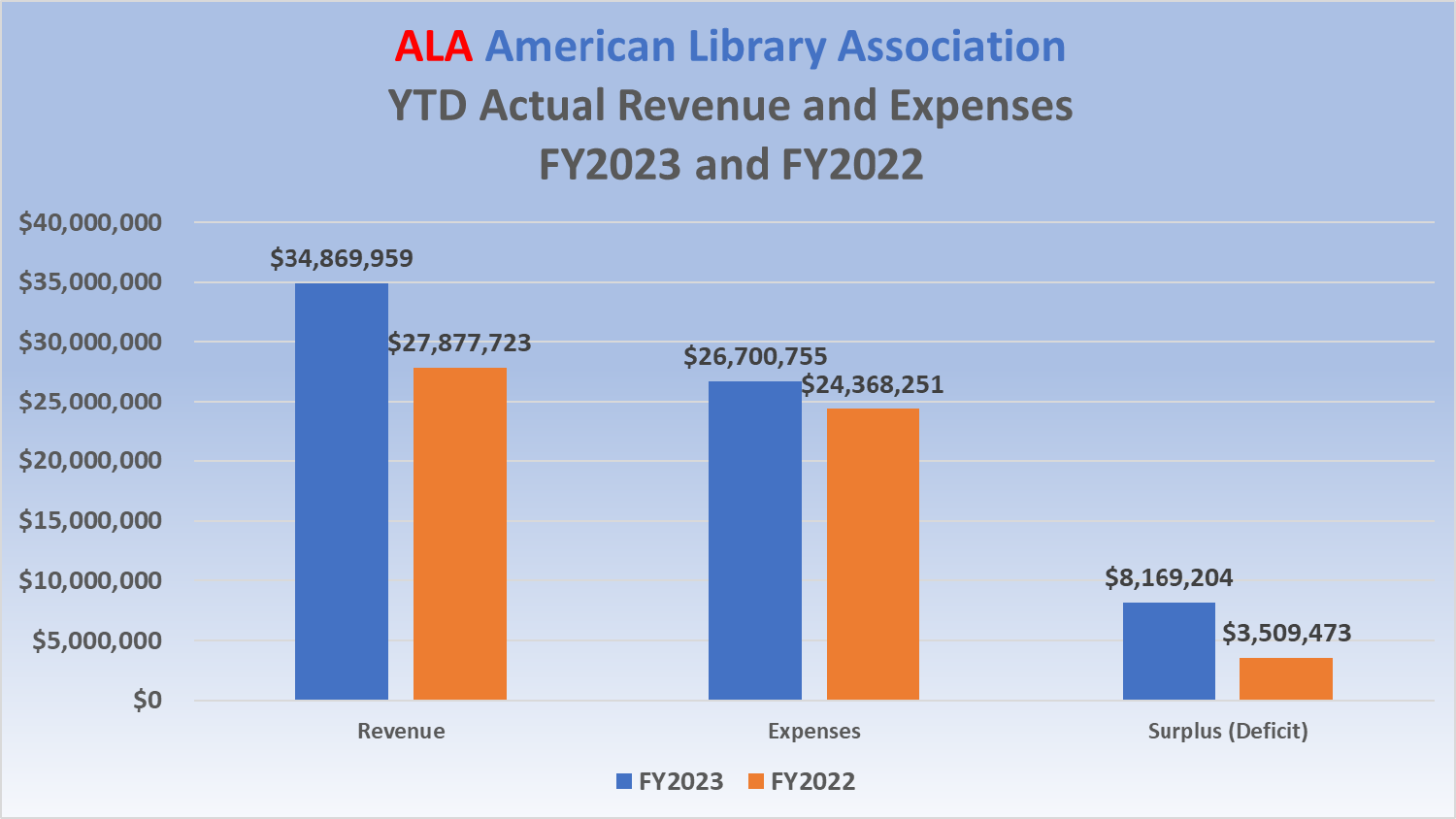
What is the difference between the FY2023 and FY2022 values for Revenue? $6,992,236 How many categories are shown on the x axis? 3 What is the FY2022 value for Surplus (Deficit)? $3,509,473 What is the difference between the FY2023 and FY2022 values for Surplus (Deficit)? $4,659,731 Which category has the lowest FY2022 value? Surplus (Deficit) Which category has the highest FY2023 value? Revenue What kind of chart is shown on the slide? Bar chart Is the FY2023 value for Expenses greater or less than $25,000,000? greater How many series does the legend list? 2 Which is larger, the FY2023 value for Expenses or the FY2022 value for Revenue? FY2022 value for Revenue What is the FY2023 value for Revenue? $34,869,959 What is the FY2022 value for Expenses? $24,368,251